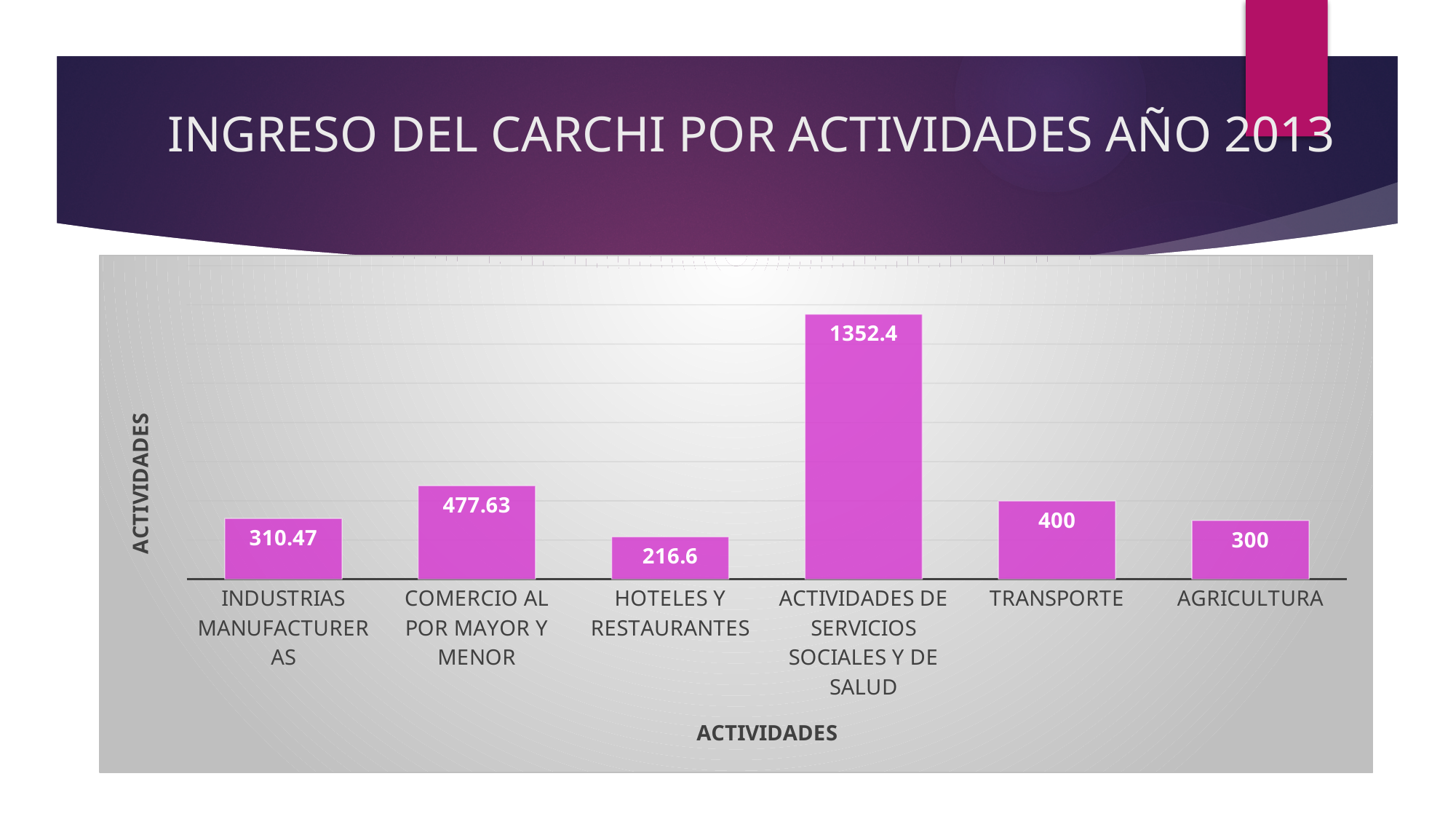
What is the value for COMERCIO AL POR MAYOR Y MENOR? 477.63 What is the difference between the values for TRANSPORTE and AGRICULTURA? 100 Which activity has the highest value? ACTIVIDADES DE SERVICIOS SOCIALES Y DE SALUD What is the value for TRANSPORTE? 400 How many activities are shown in the chart? 6 Which is larger, the value for COMERCIO AL POR MAYOR Y MENOR or the value for TRANSPORTE? COMERCIO AL POR MAYOR Y MENOR What is the title of the slide? INGRESO DEL CARCHI POR ACTIVIDADES AÑO 2013 Which activity has the lowest value? HOTELES Y RESTAURANTES What is the difference between the values for ACTIVIDADES DE SERVICIOS SOCIALES Y DE SALUD and COMERCIO AL POR MAYOR Y MENOR? 874.77 What kind of chart is shown on the slide? Bar chart What is the value for INDUSTRIAS MANUFACTURERAS? 310.47 What is the value for HOTELES Y RESTAURANTES? 216.6